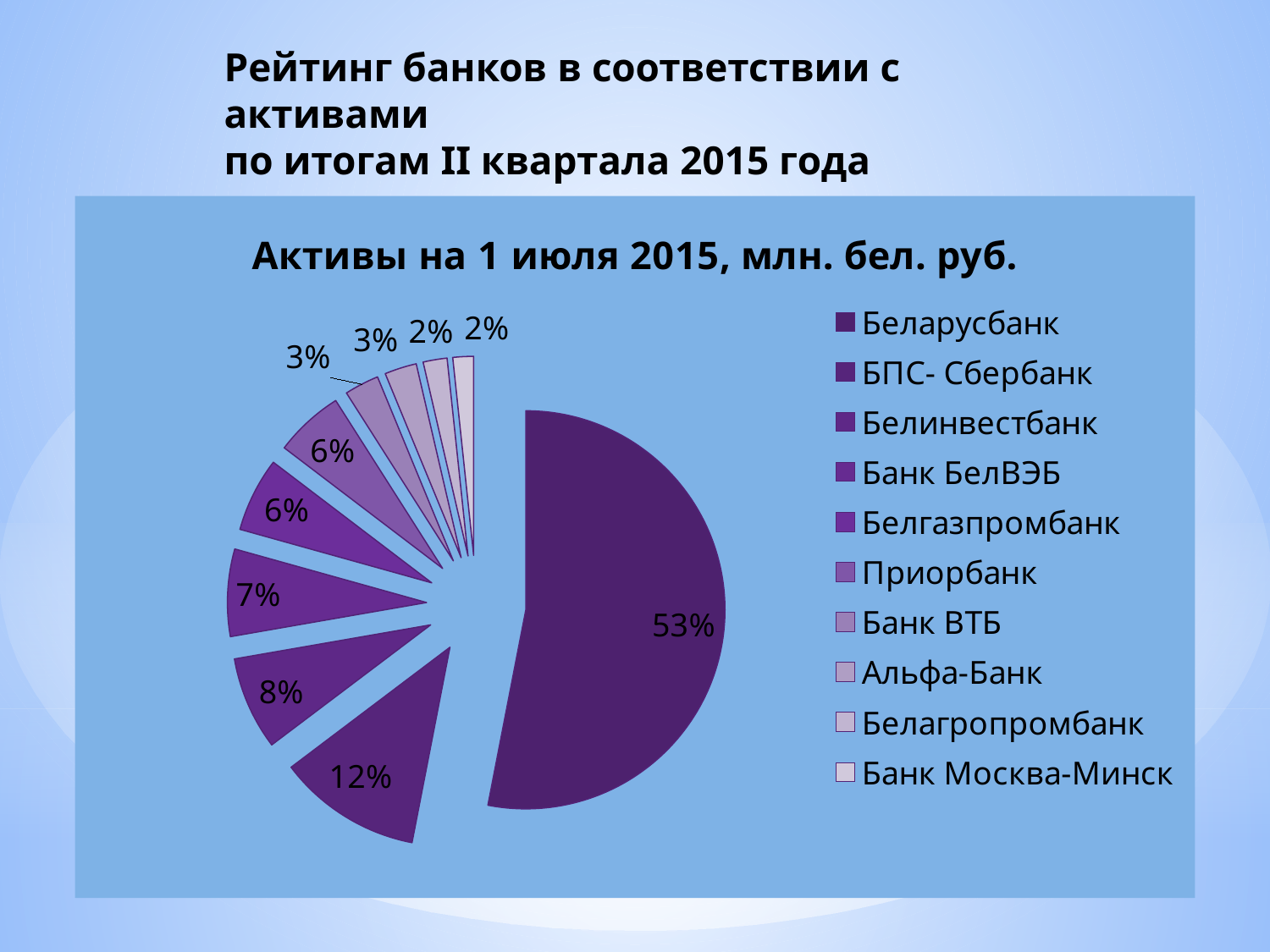
Which has a larger share, Белинвестбанк or Банк БелВЭБ? Белинвестбанк What is the difference in percentage points between Беларусбанк and БПС- Сбербанк? 41 What is the value shown for Банк БелВЭБ? 7% What is the value shown for Белинвестбанк? 8% Which bank has the largest slice of the pie? Беларусбанк What is the value shown for БПС- Сбербанк? 12% Which bank is listed first in the legend? Беларусбанк What is the title of the chart? Активы на 1 июля 2015, млн. бел. руб. What is the value shown for Белгазпромбанк? 6% What type of chart is shown on the slide? pie chart What share of the pie does Беларусбанк hold? 53% How many banks are listed in the chart legend? 10